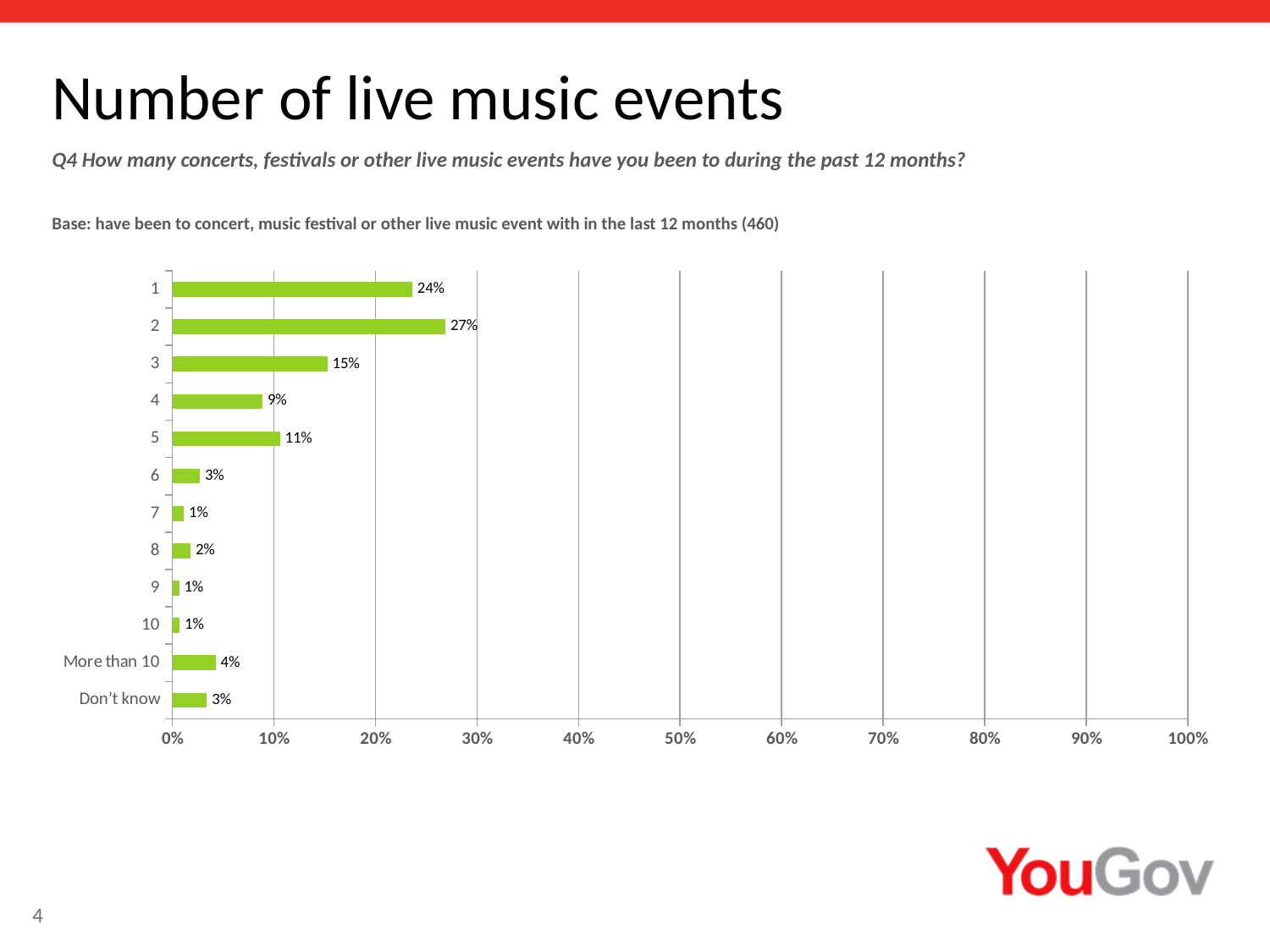
What is the difference between the values for 1 event and 3 events? 9% Which category has the highest value? 2 Is the value for 2 events greater or less than 20%? greater Which is larger, the value for 4 events or the value for 5 events? 5 What kind of chart is shown on the slide? bar chart What colour are the bars in the chart? green How many categories are shown on the chart? 12 What percentage of respondents attended 2 live music events? 27% What percentage of respondents answered 'Don't know'? 3% What is the value for the 'More than 10' category? 4% What is the combined value for 6, 7 and 8 events? 6% What is the highest value shown on the x axis? 100%